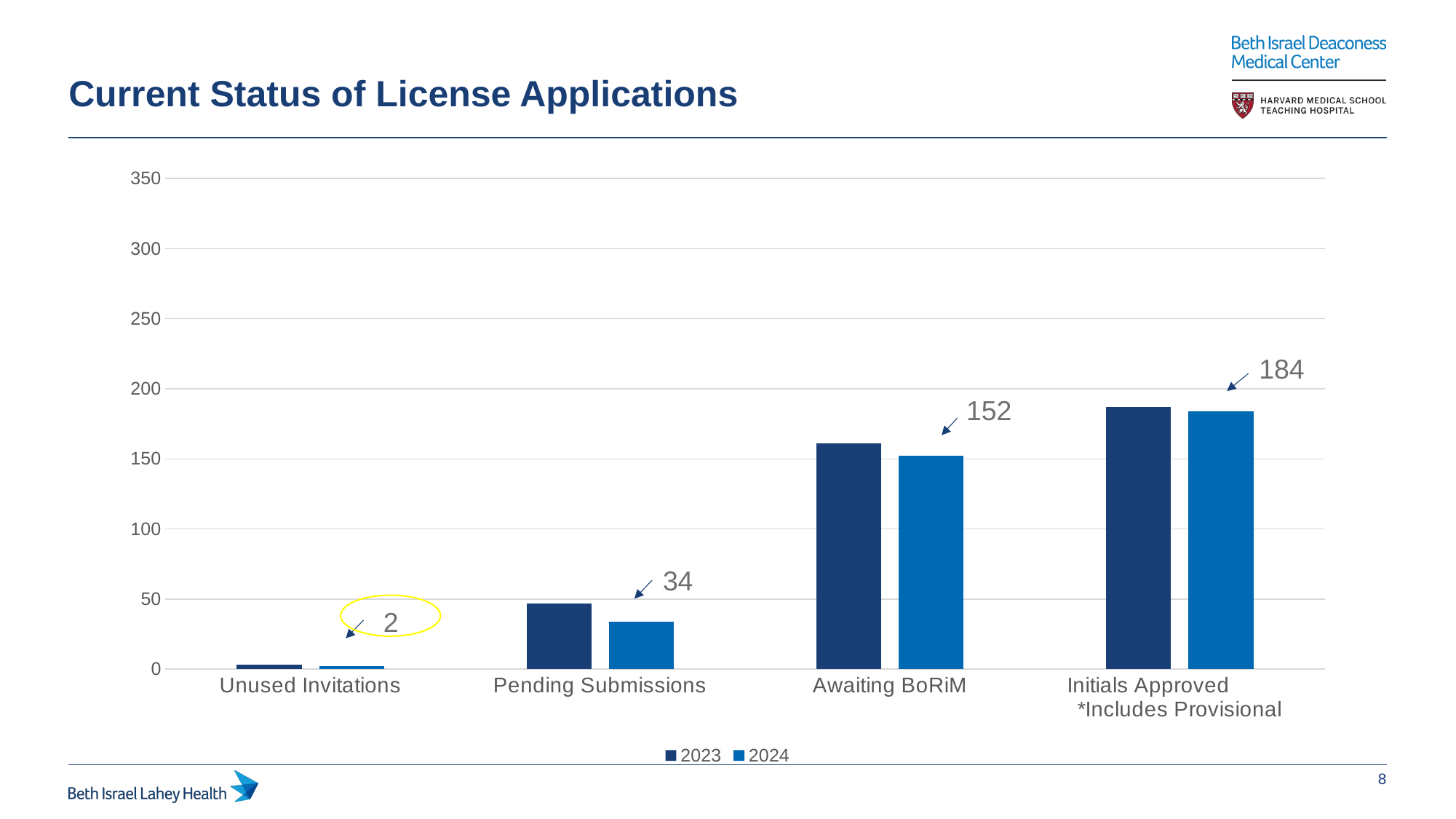
Which category has the highest 2024 value? Initials Approved *Includes Provisional What is the 2024 value for Awaiting BoRiM? 152 How many series does the legend list? 2 What is the 2024 value for Pending Submissions? 34 What is the 2024 value for Unused Invitations? 2 For Pending Submissions, which series has the larger value, 2023 or 2024? 2023 Is the 2023 value for Initials Approved *Includes Provisional greater or less than 200? less Which category has the lowest 2024 value? Unused Invitations What is the 2024 value for Initials Approved *Includes Provisional? 184 What is the difference between the 2024 values for Initials Approved *Includes Provisional and Awaiting BoRiM? 32 How many categories are shown on the x axis? 4 Is the 2023 value for Awaiting BoRiM greater or less than 150? greater